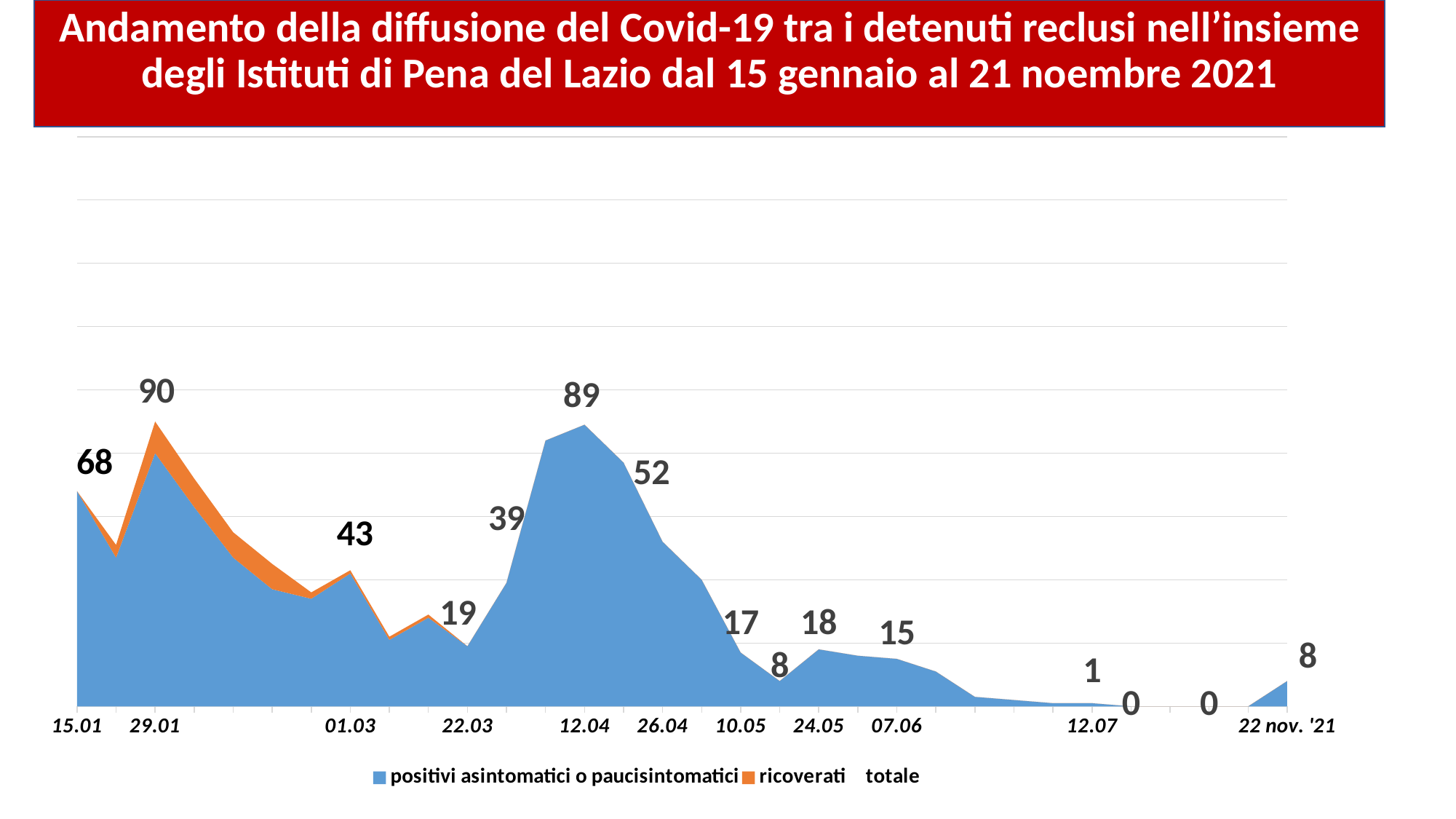
How many series does the legend list? 3 What kind of chart is shown on the slide? area chart What is the total value labelled at 22 nov. '21? 8 What is the total value labelled at 26.04? 52 Which legend entry is shown in orange? ricoverati What is the total value labelled at 15.01? 68 What is the total value labelled at 29.01? 90 Which labelled date has the highest total value? 29.01 What is the total value labelled at 12.04? 89 What is the difference between the total at 29.01 and the total at 12.04? 1 Which is larger, the total at 01.03 or the total at 26.04? 26.04 Do the values rise or fall from 12.04 to 10.05? fall